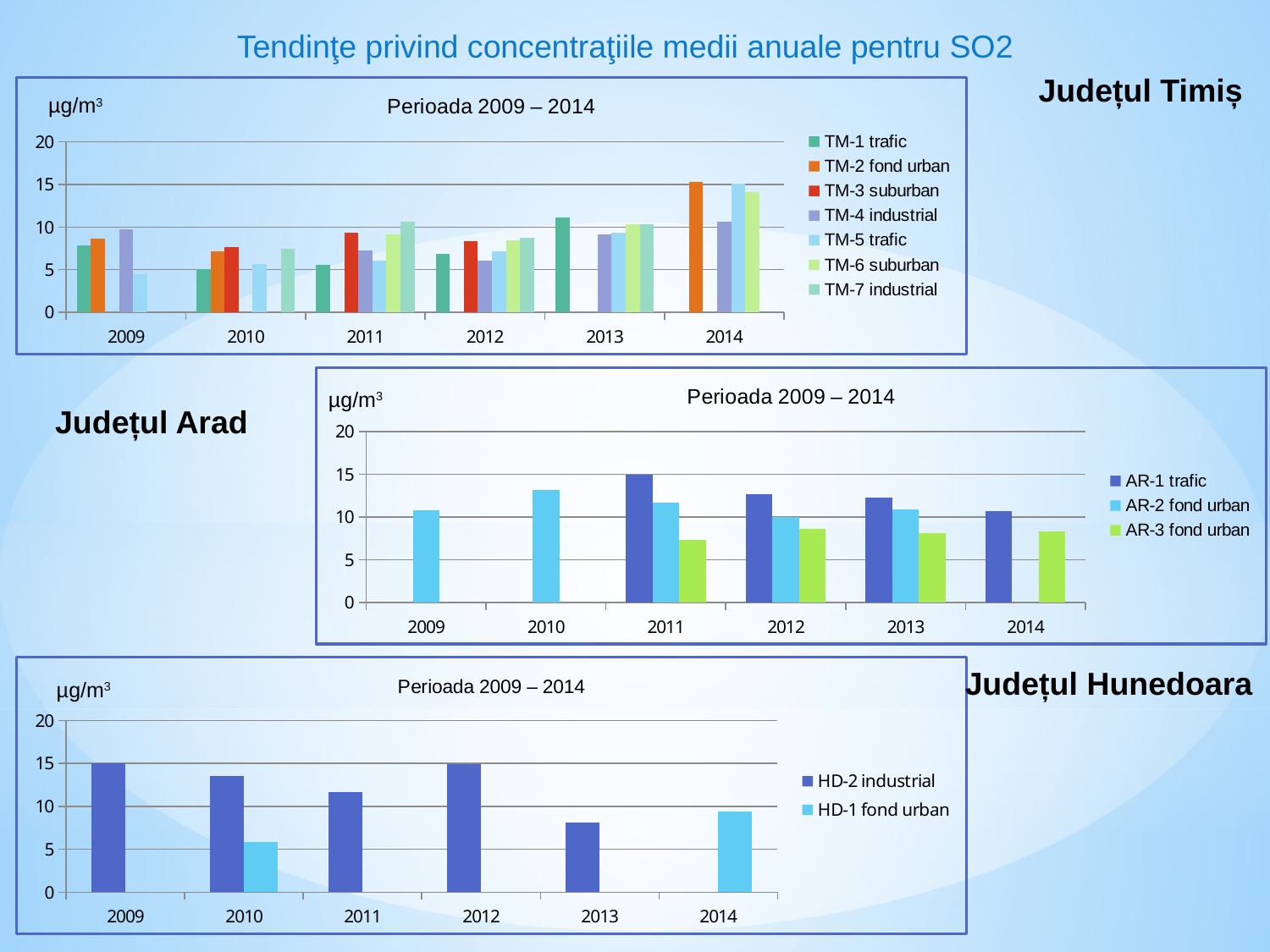
In the Județul Arad chart, which year has the highest value for AR-1 trafic? 2011 In the Județul Timiș chart, is the value for TM-1 trafic in 2013 greater or less than 10? greater In the Județul Timiș chart, is the value for TM-5 trafic in 2009 greater or less than 5? less In the Județul Hunedoara chart, how many years are shown on the x axis? 6 In the Județul Arad chart, do the values for AR-1 trafic rise or fall from 2011 to 2014? fall In the Județul Hunedoara chart, which year has the lowest value for HD-2 industrial? 2013 In the Județul Arad chart, is the value for AR-3 fond urban in 2011 greater or less than 10? less What kind of chart is the Județul Arad chart? bar chart In the Județul Timiș chart, how many series does the legend list? 7 In the Județul Arad chart, how many series does the legend list? 3 In the Județul Hunedoara chart, which is larger for HD-2 industrial: 2010 or 2011? 2010 In the Județul Hunedoara chart, how many series does the legend list? 2